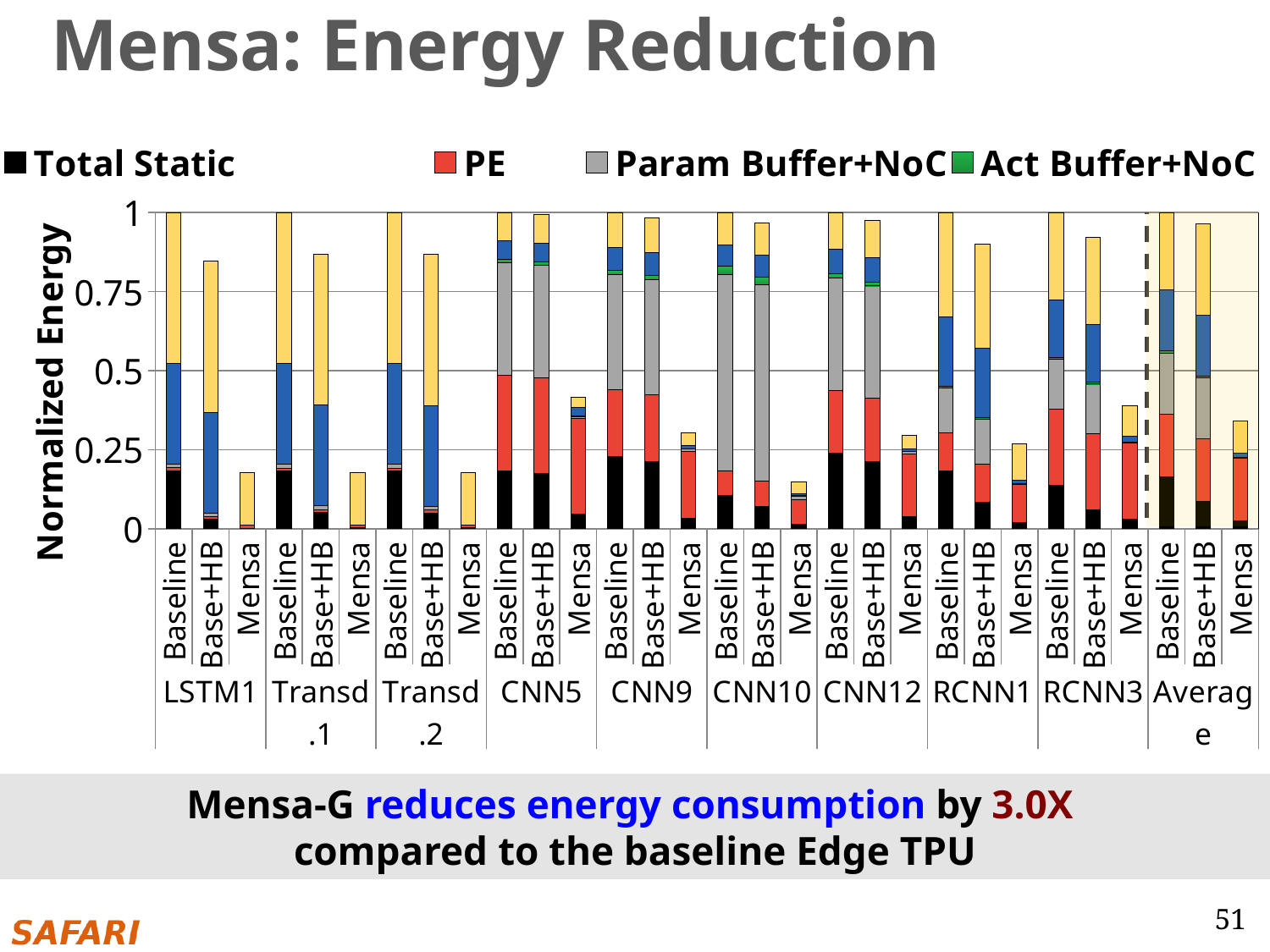
How many bars are plotted for each workload group? 3 How many workload groups are shown along the x axis (including Average)? 10 What is the y-axis title of the chart? Normalized Energy Which is larger: the Mensa total for CNN5 or the Mensa total for LSTM1? CNN5 What is the total normalized energy of the Baseline bar for LSTM1? 1 Which configuration has the lowest total normalized energy in the CNN10 group? Mensa How many series does the legend list? 4 Is the total for Mensa in CNN5 greater or less than 0.5? less Is the total for Mensa in the Average group greater or less than 0.25? greater What kind of chart is shown on the slide? Stacked bar chart Is the total for Mensa in LSTM1 greater or less than 0.25? less